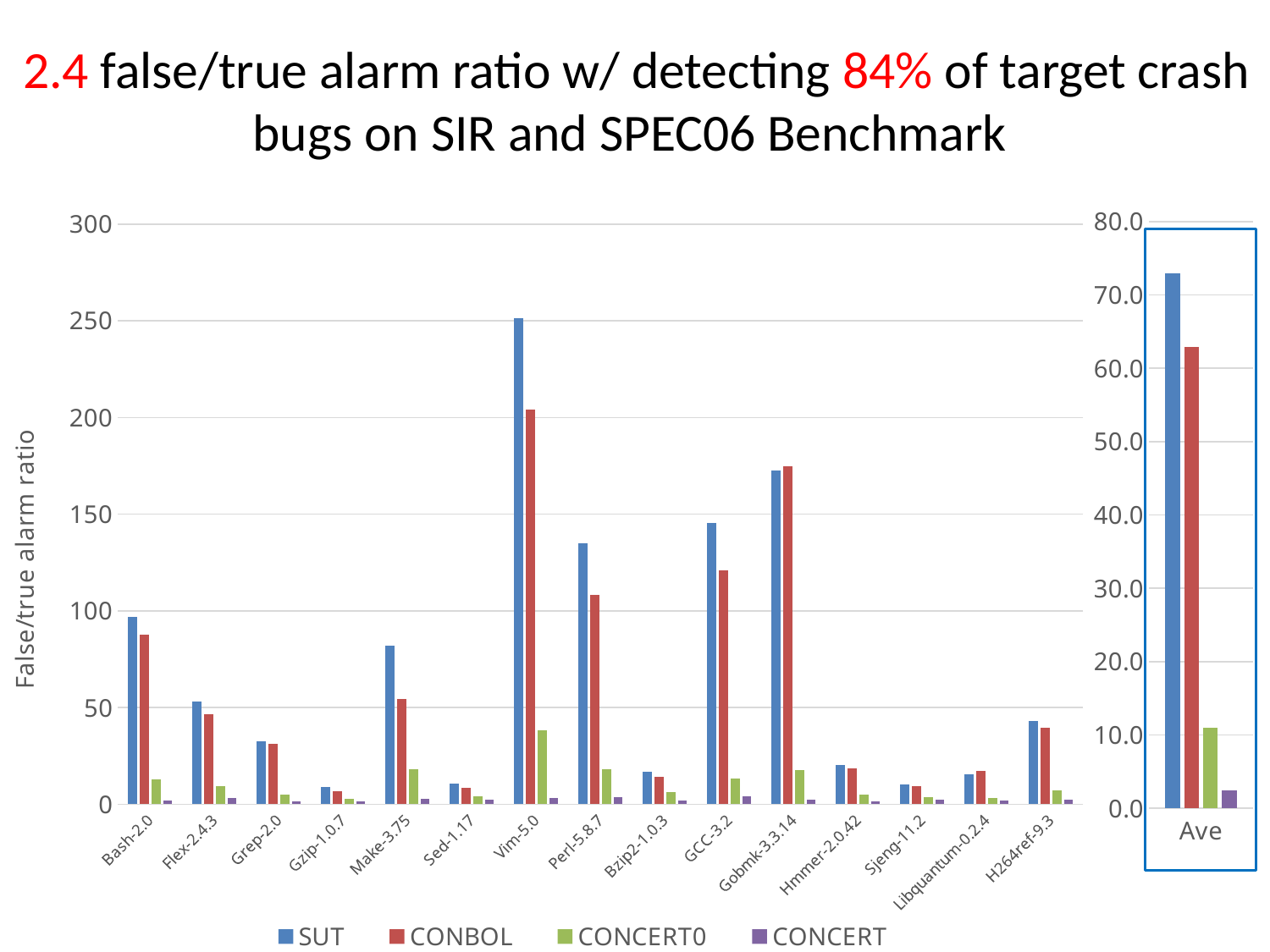
In the main chart, is the CONBOL value for Vim-5.0 greater or less than 150? greater In the Ave chart on the right, which series has the highest value? SUT What kind of chart is the main chart on the left of the slide? bar chart In the main chart, is the SUT value for Bash-2.0 greater or less than 50? greater What is the y-axis title of the main chart? False/true alarm ratio In the Ave chart on the right, is the CONBOL value greater or less than 70.0? less In the main chart, which is larger for Perl-5.8.7, the SUT value or the CONBOL value? SUT In the main chart, which is larger for GCC-3.2, the SUT value or the CONBOL value? SUT How many benchmark categories are shown on the x axis of the main chart? 15 How many series does the legend of the main chart list? 4 In the main chart, which category has the highest SUT value? Vim-5.0